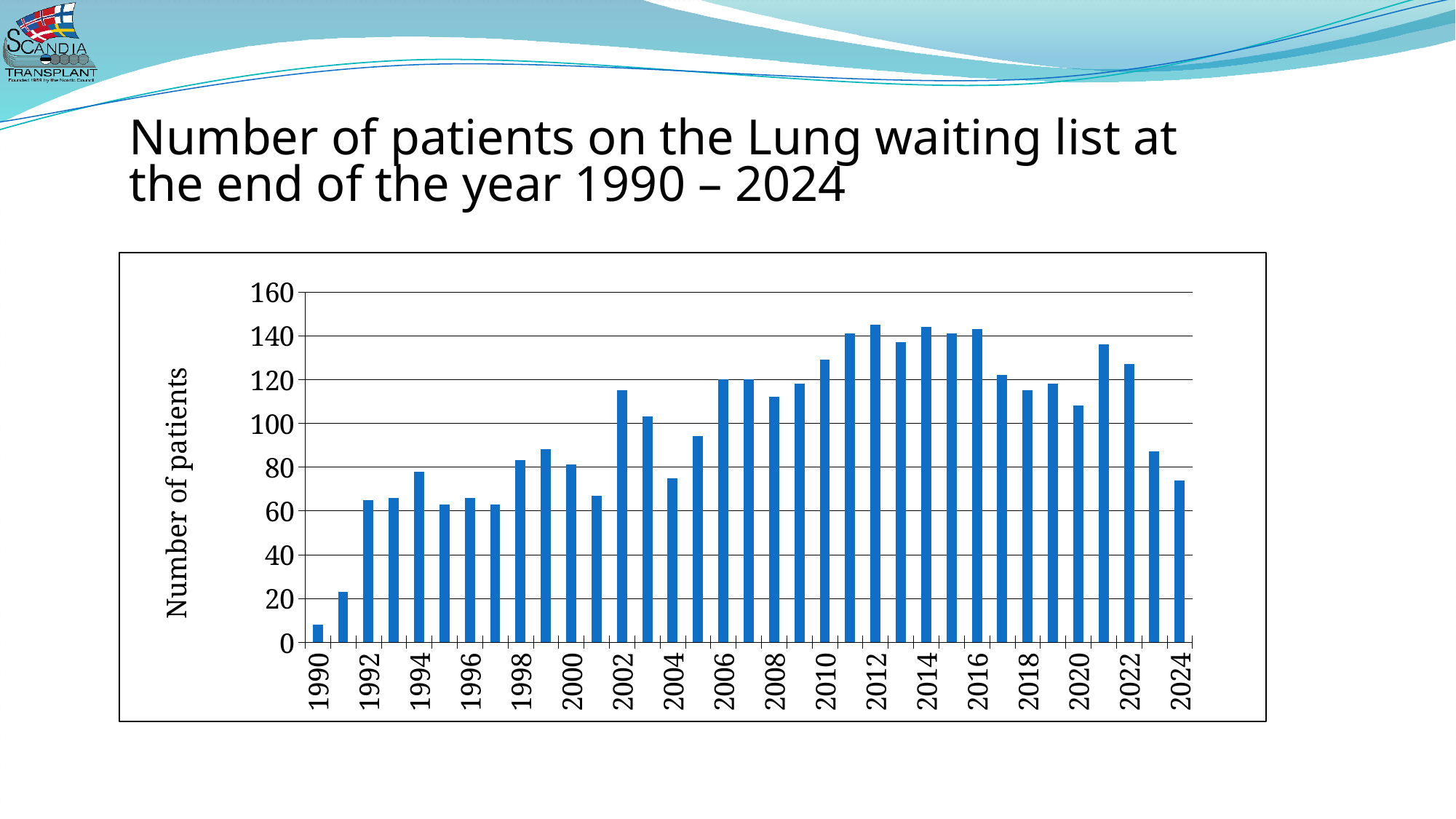
How many years (bars) are plotted in the chart? 35 Is the value for 1990 greater or less than 20? less Is the value for 2024 greater or less than 80? less Is the value for 2012 greater or less than 140? greater What kind of chart is shown on the slide? bar chart Do the values rise or fall from 2021 to 2024? fall Which year has the lowest number of patients on the lung waiting list? 1990 Which year has the larger value, 2021 or 2023? 2021 Which year has the larger value, 2002 or 2004? 2002 What is the label of the vertical axis? Number of patients